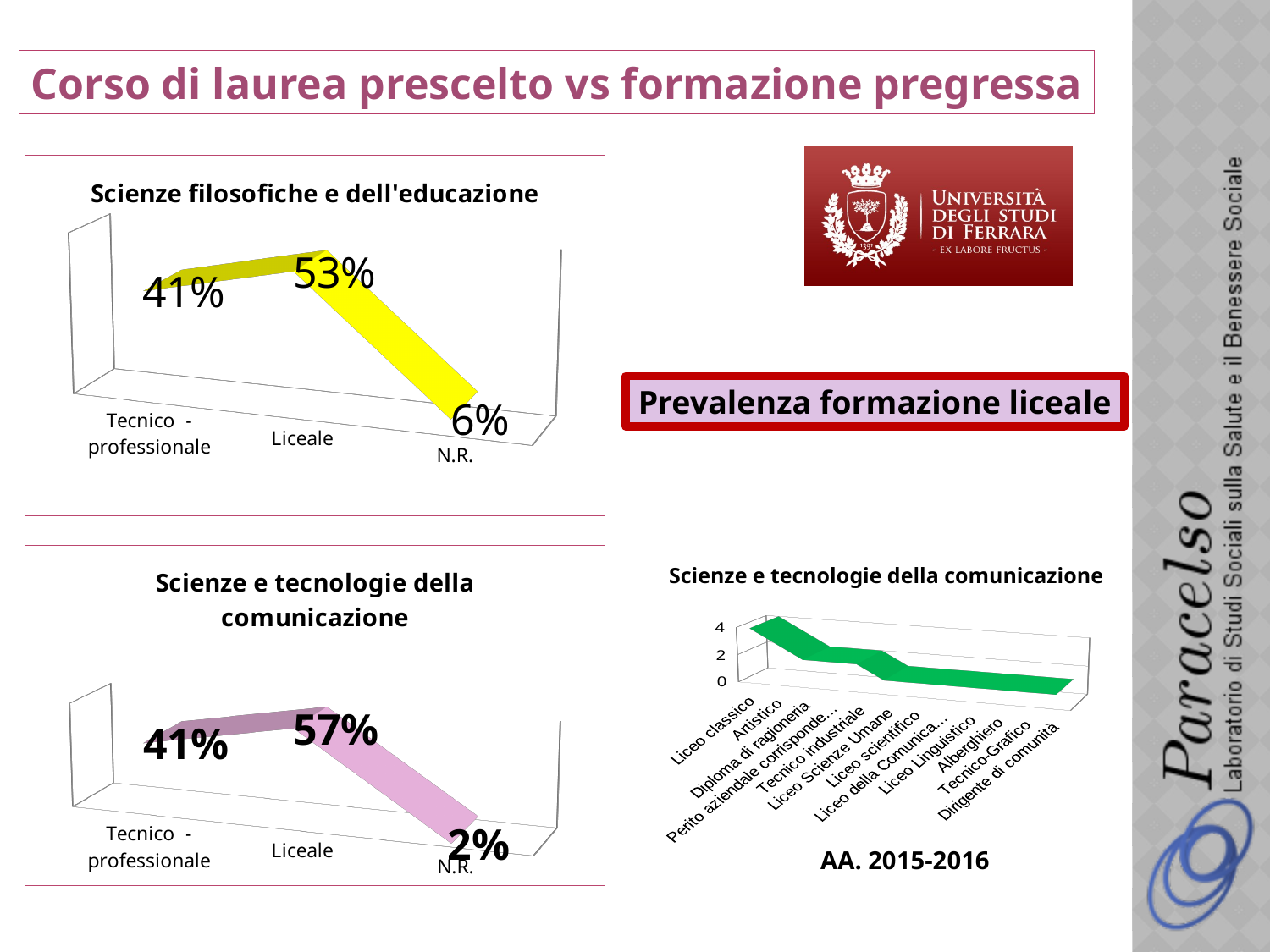
In the bottom-left chart titled 'Scienze e tecnologie della comunicazione', what is the difference between the Liceale and N.R. values? 55% Which is larger: the Liceale value in the 'Scienze filosofiche e dell'educazione' chart or the Liceale value in the bottom-left 'Scienze e tecnologie della comunicazione' chart? Scienze e tecnologie della comunicazione (57%) In the chart titled 'Scienze filosofiche e dell'educazione', what is the value for N.R.? 6% In the chart titled 'Scienze filosofiche e dell'educazione', what is the value for Tecnico - professionale? 41% In the bottom-left chart titled 'Scienze e tecnologie della comunicazione', what is the value for N.R.? 2% How many categories are shown on the x axis of the bottom-right chart titled 'Scienze e tecnologie della comunicazione'? 12 In the bottom-left chart titled 'Scienze e tecnologie della comunicazione', which category has the lowest value? N.R. In the bottom-left chart titled 'Scienze e tecnologie della comunicazione', what is the value for Liceale? 57% In the chart titled 'Scienze filosofiche e dell'educazione', which category has the highest value? Liceale In the bottom-right chart titled 'Scienze e tecnologie della comunicazione', do the values rise or fall from Liceo classico to Dirigente di comunità? fall In the chart titled 'Scienze filosofiche e dell'educazione', what is the difference between the Liceale and Tecnico - professionale values? 12% In the chart titled 'Scienze filosofiche e dell'educazione', what is the value for Liceale? 53%